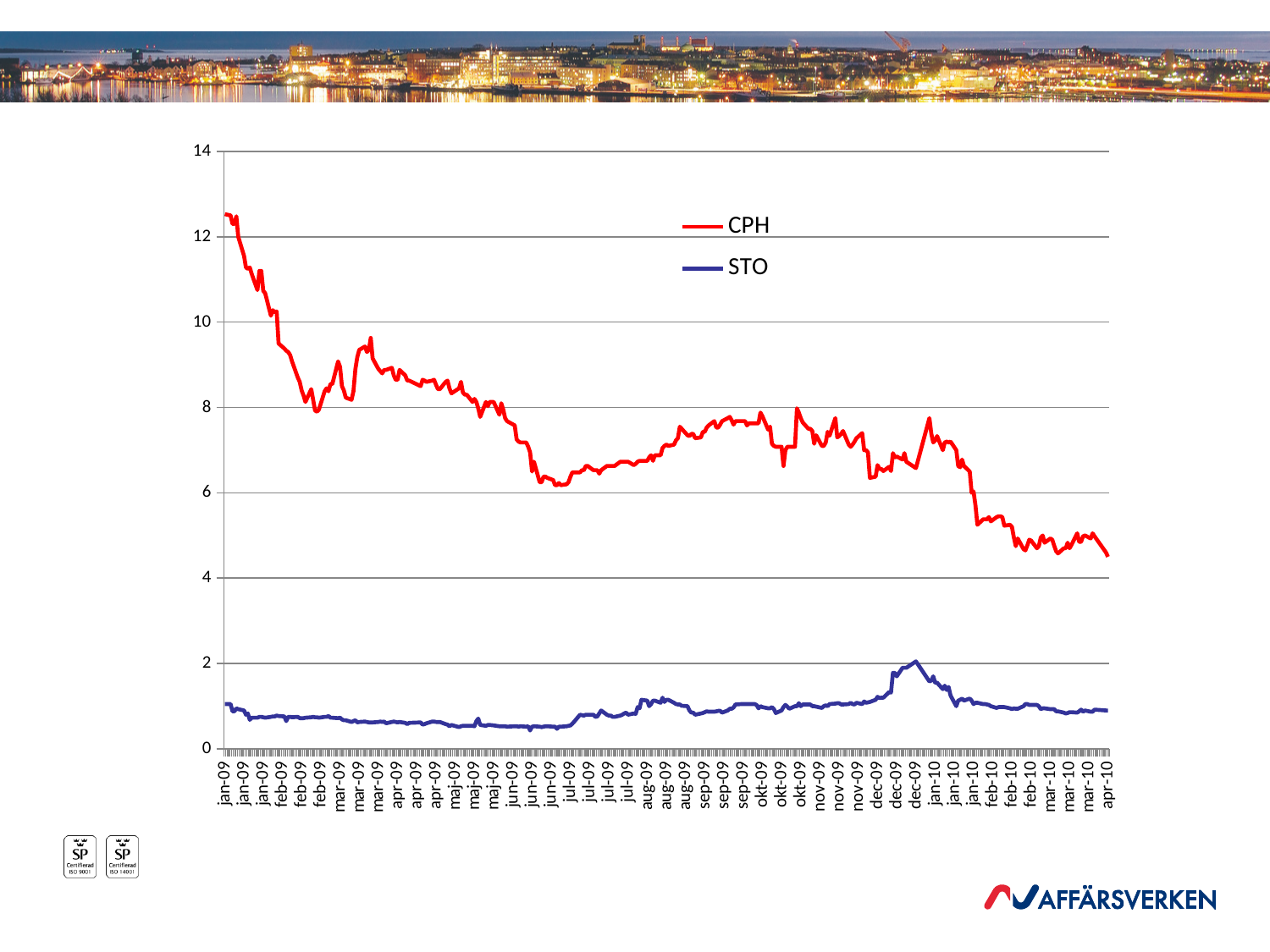
Is the value for CPH at jan-09 greater or less than 12? greater What are the two series named in the legend? CPH and STO In which month does the CPH line reach its highest value? jan-09 Which colour is used for the STO line? blue How many series does the legend list? 2 What kind of chart is shown on the slide? line chart Does the CPH line overall rise or fall from jan-09 to apr-10? fall Which series has the larger value at jul-09, CPH or STO? CPH Is the value for CPH at okt-09 greater or less than 6? greater Is the value for STO at jan-09 greater or less than 2? less In which month does the STO line reach its highest value? dec-09